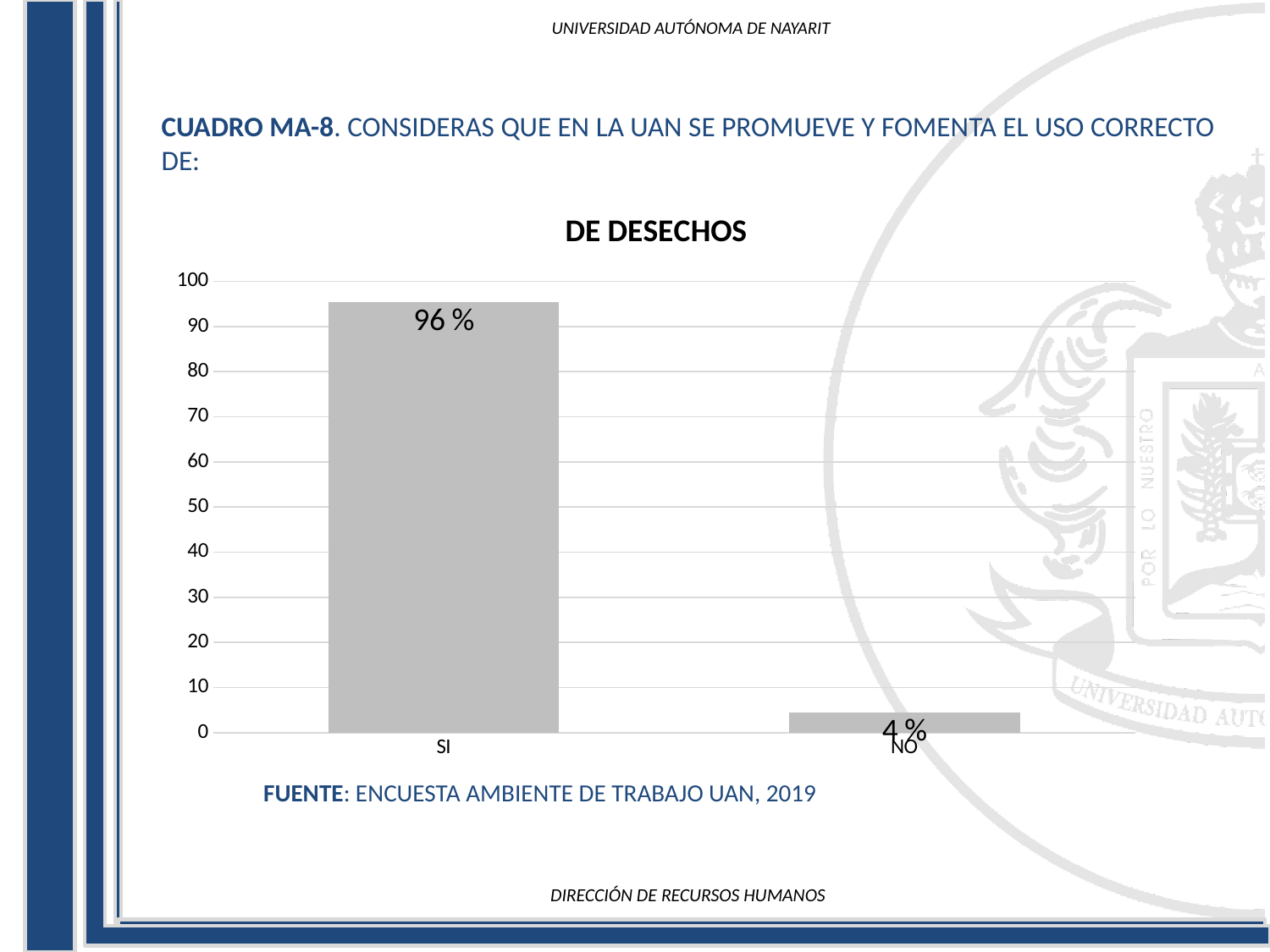
Which category has the lowest value? NO Which category has the highest value? SI Is the value for NO greater or less than 10? less Which is larger, the value for SI or the value for NO? SI What kind of chart is shown? bar chart What is the difference between the values for SI and NO? 92 % How many categories are shown on the x axis? 2 What is the value for NO? 4 % What is the value for SI? 96 % What is the highest value shown on the y axis? 100 Is the value for SI greater or less than 90? greater What is the title of the chart? DE DESECHOS